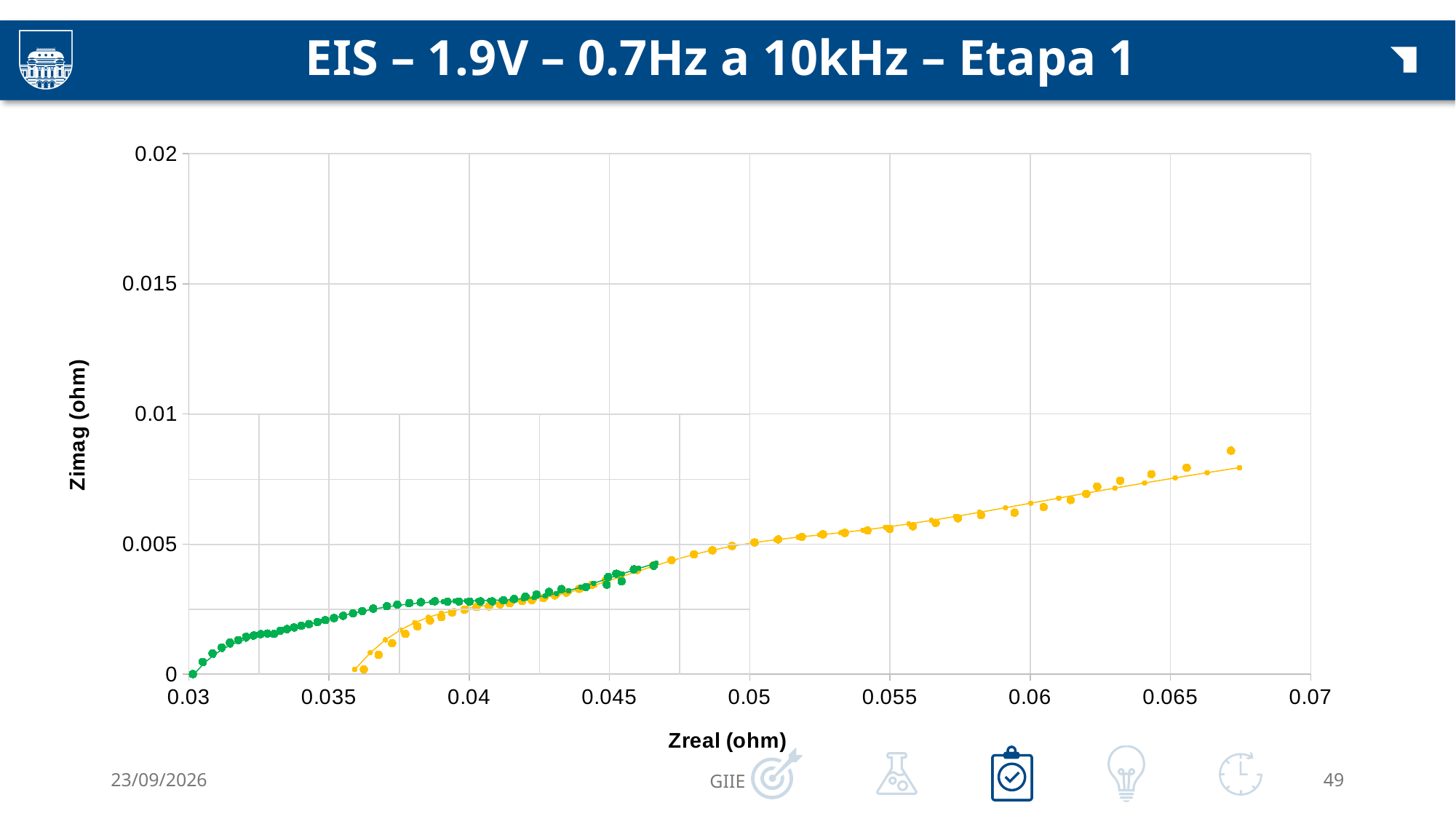
Is the highest Zimag value plotted on the chart greater or less than 0.01? less Which series reaches higher Zreal values, the green or the yellow one? Yellow What kind of chart is shown on the slide? Scatter chart Which series starts at a lower Zreal value, the green or the yellow one? Green Does Zimag generally rise or fall as Zreal increases along the x axis? Rise Is the highest Zimag value of the yellow series greater or less than 0.005? greater Is the highest Zimag value of the green series greater or less than 0.005? less What colours are the two data series plotted on the chart? Green and yellow Which series reaches the higher maximum Zimag value, the green or the yellow one? Yellow What is the title of the chart on the slide? EIS – 1.9V – 0.7Hz a 10kHz – Etapa 1